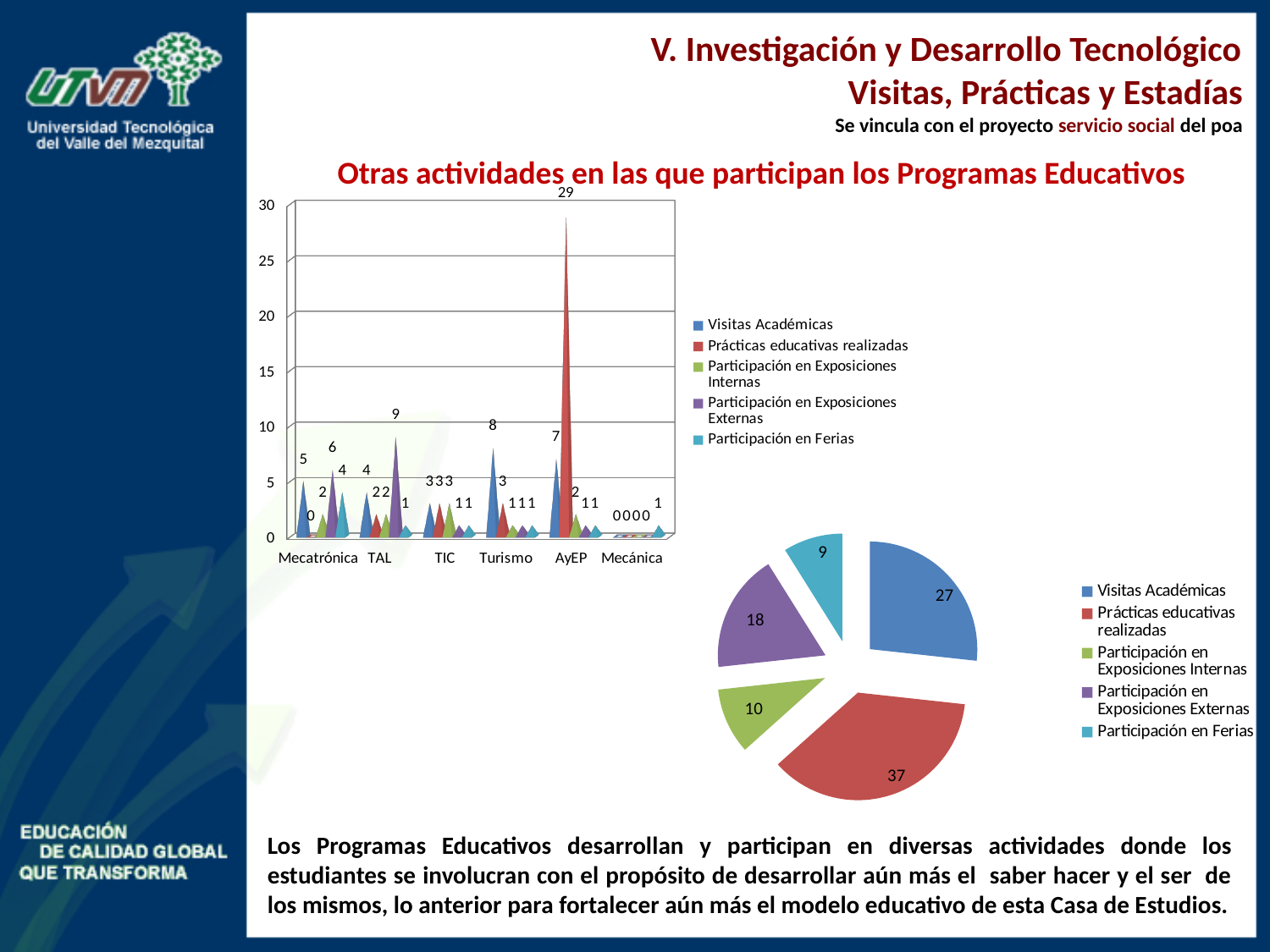
How many categories are shown on the x axis of the bar chart 'Otras actividades en las que participan los Programas Educativos'? 6 In the pie chart at the bottom right, what is the difference between Visitas Académicas and Participación en Exposiciones Externas? 9 In the bar chart 'Otras actividades en las que participan los Programas Educativos', what is the value of Prácticas educativas realizadas for AyEP? 29 In the pie chart at the bottom right, which slice is the largest? Prácticas educativas realizadas What kind of chart is the upper chart titled 'Otras actividades en las que participan los Programas Educativos'? bar chart In the bar chart 'Otras actividades en las que participan los Programas Educativos', what is the value of Visitas Académicas for Turismo? 8 In the bar chart 'Otras actividades en las que participan los Programas Educativos', what is the value of Participación en Exposiciones Externas for TAL? 9 In the pie chart at the bottom right, which slice is the smallest? Participación en Ferias In the bar chart 'Otras actividades en las que participan los Programas Educativos', is the value of Prácticas educativas realizadas for AyEP greater or less than 25? greater In the pie chart at the bottom right, what is the value for Prácticas educativas realizadas? 37 How many series does the legend of the bar chart 'Otras actividades en las que participan los Programas Educativos' list? 5 In the bar chart 'Otras actividades en las que participan los Programas Educativos', which category has the highest single value? AyEP